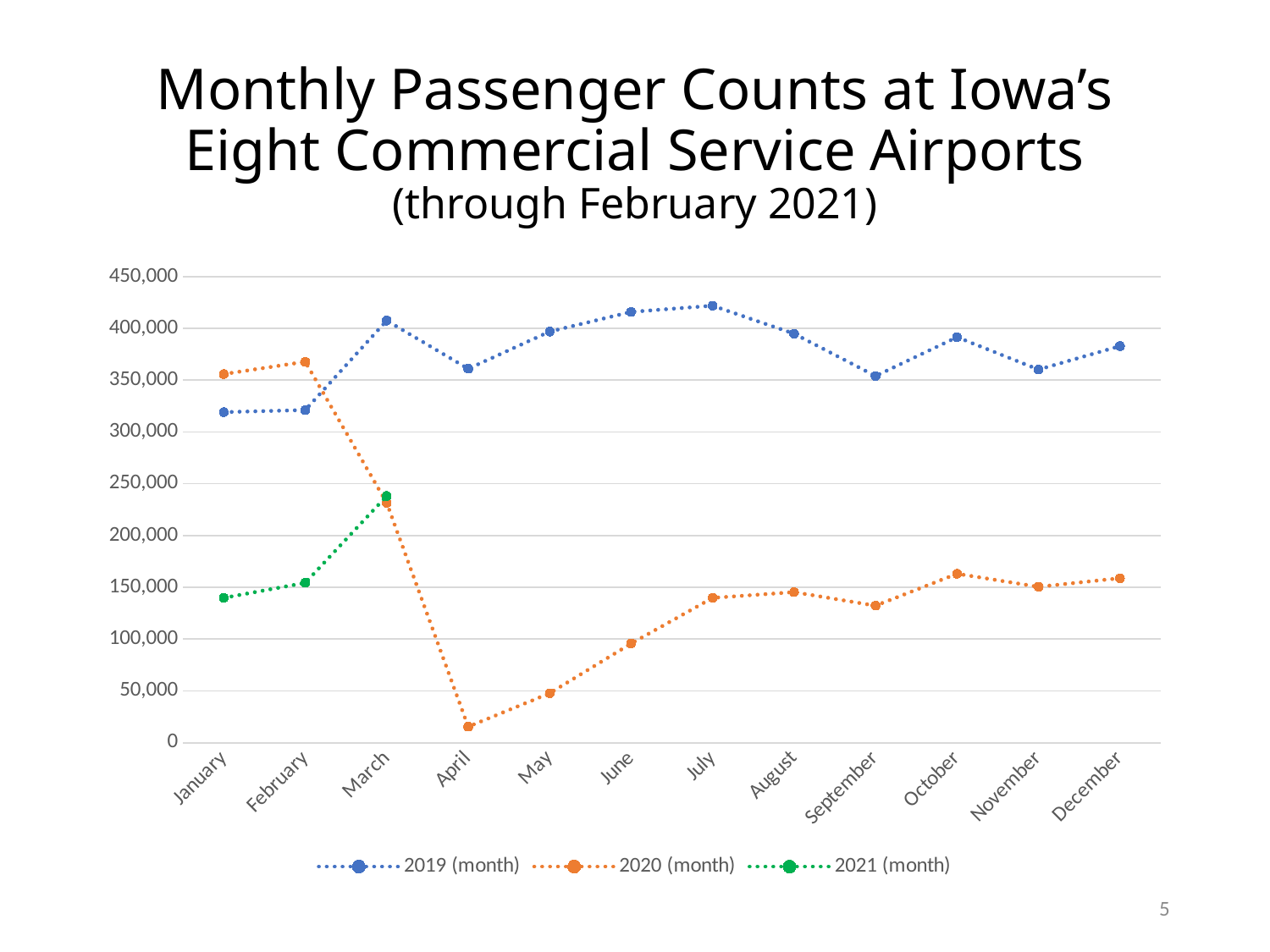
Is the value for 2020 (month) in October greater or less than 150,000? greater Does the 2020 (month) series rise or fall from February to April? fall How many series does the legend list? 3 What kind of chart is shown on the slide? line chart In which month is the 2020 (month) series at its lowest? April How many months are shown along the x axis? 12 Is the value for 2019 (month) in July greater or less than 400,000? greater Which series has the larger value in January, 2019 (month) or 2020 (month)? 2020 (month) In which month is the 2020 (month) series at its highest? February Which series has the larger value in April, 2019 (month) or 2020 (month)? 2019 (month) Is the value for 2019 (month) in September greater or less than 400,000? less